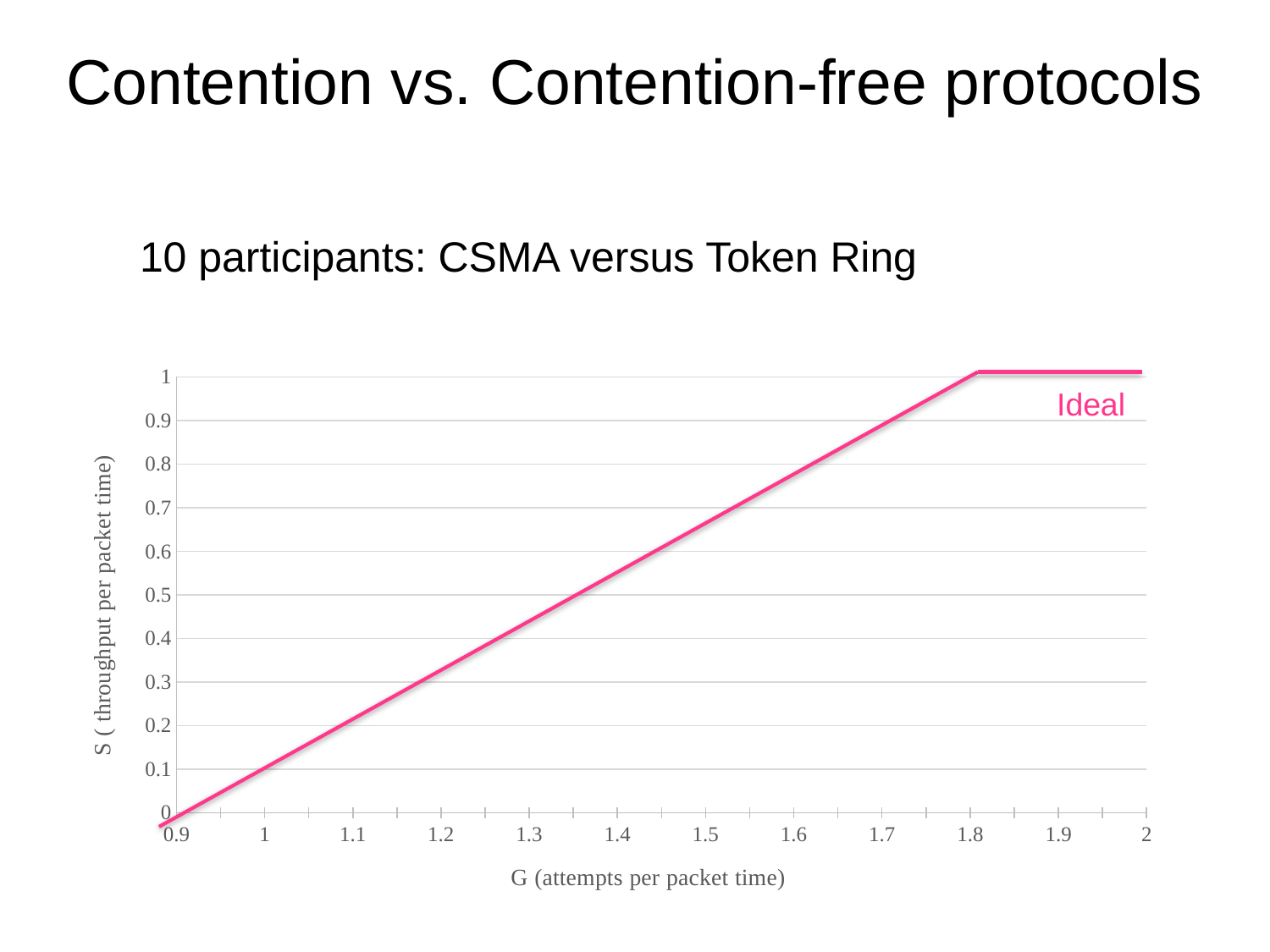
What kind of chart is shown on the slide? line chart What is the x-axis label of the chart? G (attempts per packet time) Is the value of the Ideal line at G = 1.5 greater or less than 0.6? greater What is the label of the plotted line? Ideal Is the value of the Ideal line at G = 1.2 greater or less than 0.4? less Is the value of the Ideal line at G = 1.4 greater or less than 0.5? greater What is the value of the Ideal line at G = 2? 1 How many series are plotted on the chart? 1 Which is larger, the value of the Ideal line at G = 1.3 or at G = 1.7? G = 1.7 What is the value of the Ideal line at G = 0.9? 0 Does the Ideal line rise or fall as G increases from 0.9 to 1.8? rise